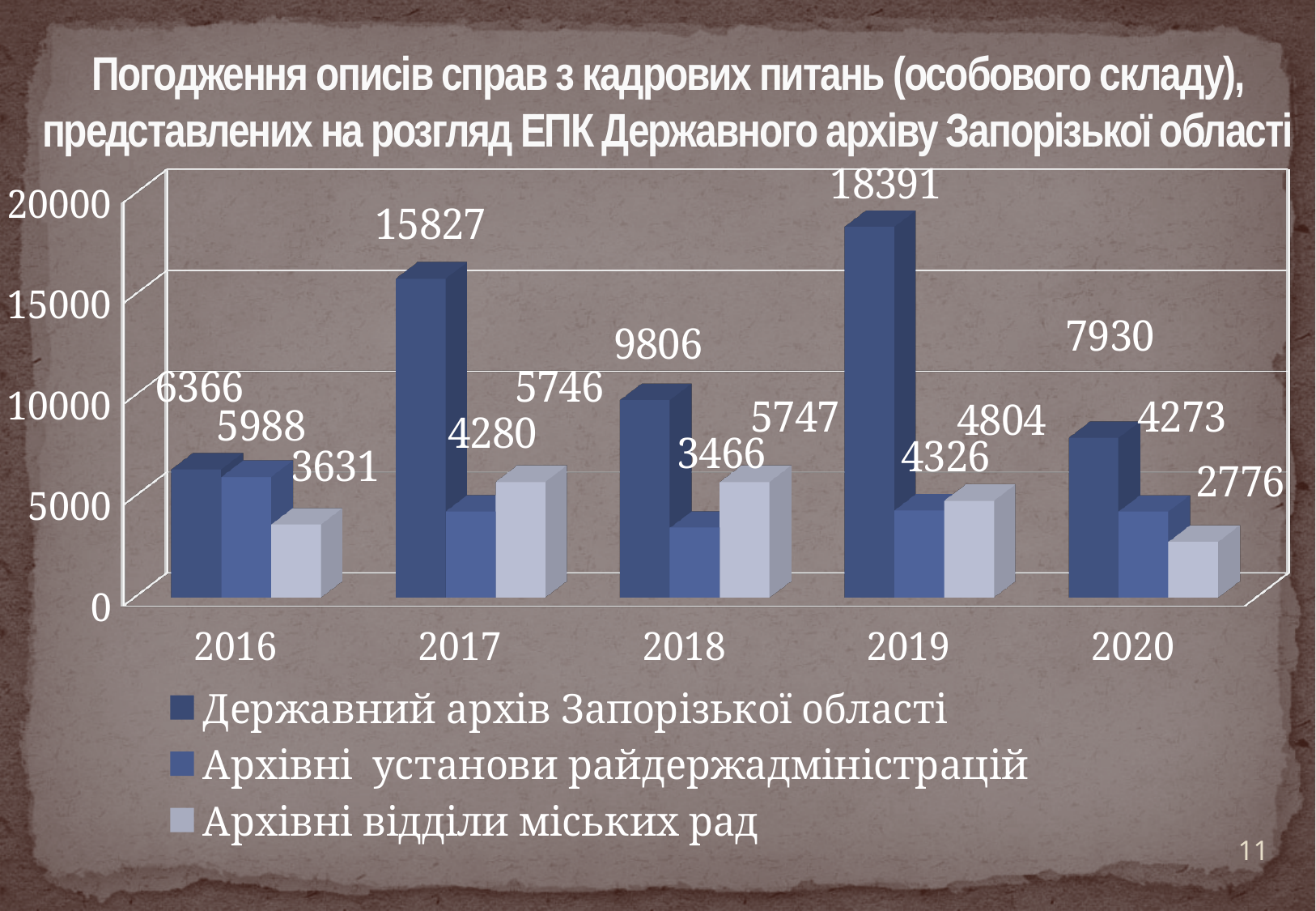
What is the difference between the Державний архів Запорізької області values for 2019 and 2017? 2564 What kind of chart is shown on the slide? bar chart What is the value for Архівні установи райдержадміністрацій in 2017? 4280 What is the value for Архівні відділи міських рад in 2020? 2776 How many series does the legend list? 3 Which is larger in 2016: Державний архів Запорізької області or Архівні установи райдержадміністрацій? Державний архів Запорізької області In which year is the value for Архівні відділи міських рад lowest? 2020 In which year is the value for Державний архів Запорізької області highest? 2019 What is the total of the three series values for 2020? 14979 Is the value for Державний архів Запорізької області in 2018 greater or less than 5000? greater How many years are shown on the x axis? 5 What is the value for Державний архів Запорізької області in 2019? 18391